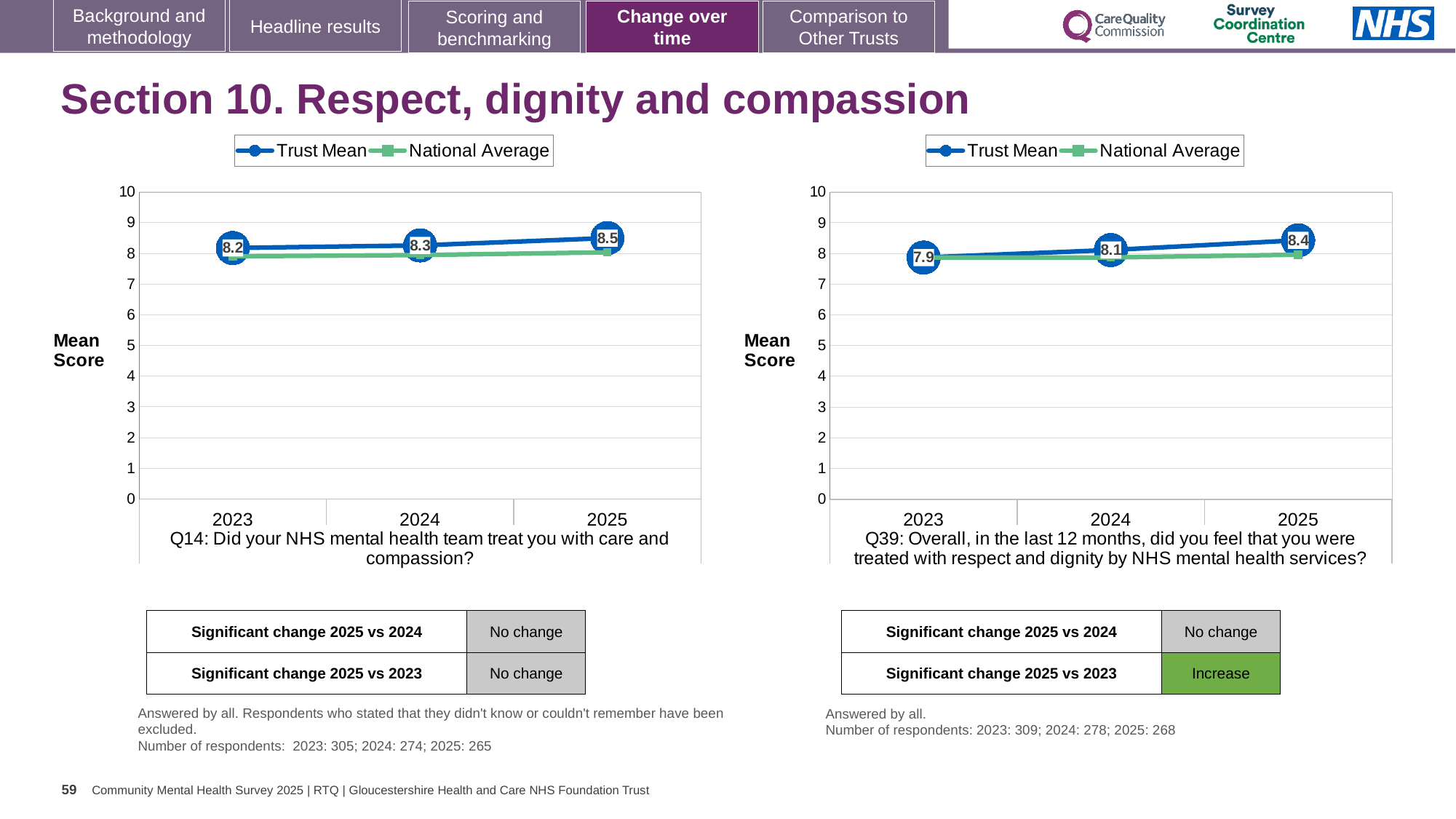
How many series does the legend of the Q39 chart (right) list? 2 In the Q39 chart (right), what is the Trust Mean for 2024? 8.1 In the Q14 chart (left), what is the Trust Mean for 2023? 8.2 In the Q14 chart (left), does the Trust Mean rise or fall from 2023 to 2025? rise In the Q14 chart (left), which year has the highest Trust Mean? 2025 What kind of chart is the Q14 chart (left)? line chart In the Q39 chart (right), what is the Trust Mean for 2023? 7.9 In the Q39 chart (right), what is the difference between the Trust Mean in 2025 and in 2023? 0.5 In the Q39 chart (right), which year has the lowest Trust Mean? 2023 In the Q14 chart (left), what is the difference between the Trust Mean in 2025 and in 2024? 0.2 In the Q14 chart (left), what is the Trust Mean for 2025? 8.5 Is the Trust Mean for 2025 in the Q14 chart (left) larger or smaller than the Trust Mean for 2025 in the Q39 chart (right)? larger